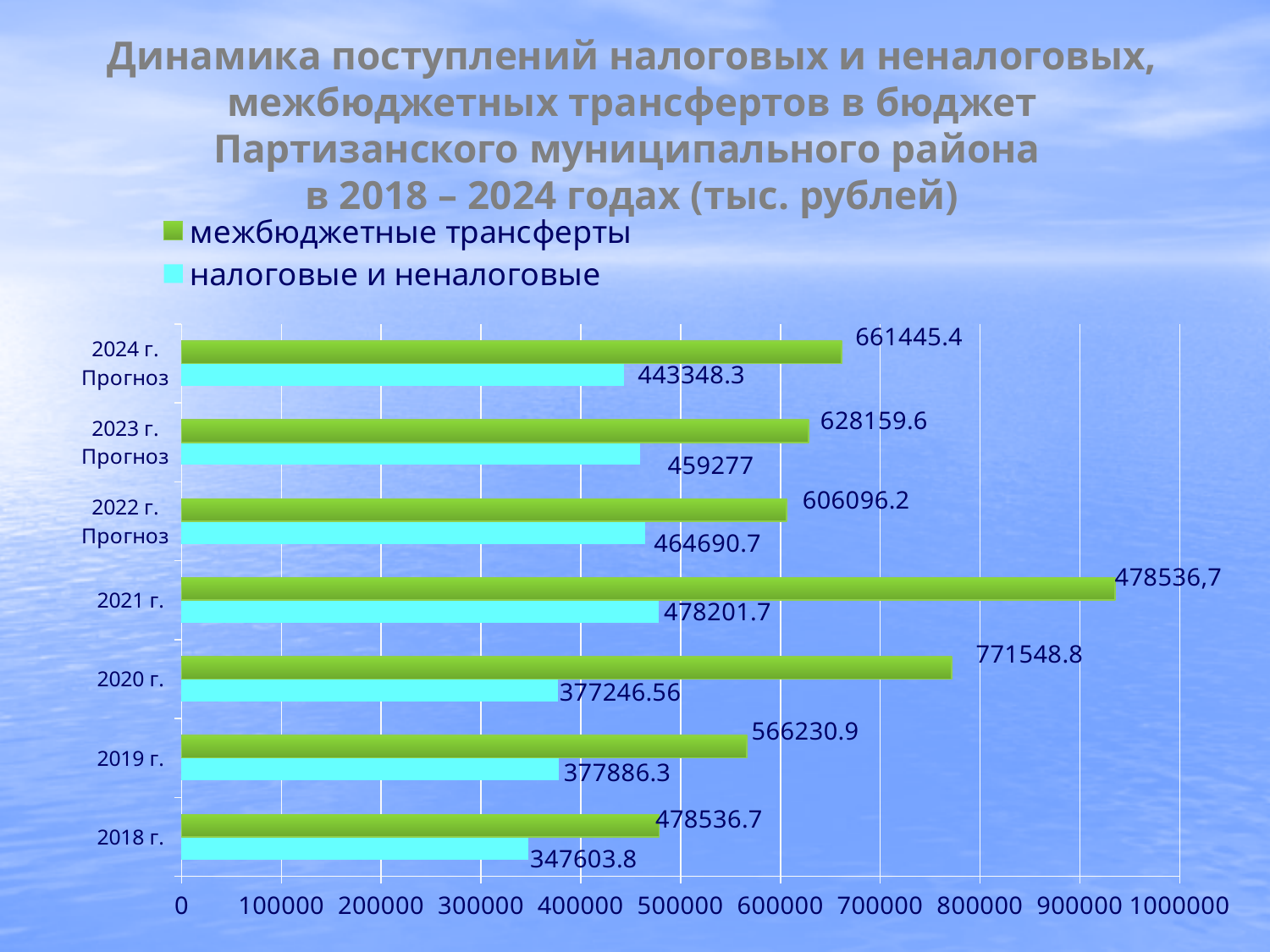
How many series does the legend list? 2 Is the value of межбюджетные трансферты for 2021 г. greater or less than 900000? greater What is the value of межбюджетные трансферты for 2024 г. Прогноз? 661445.4 How many year categories are shown on the chart? 7 What is the value of межбюджетные трансферты for 2023 г. Прогноз? 628159.6 Which year has the lowest value for налоговые и неналоговые? 2018 г. What is the value of налоговые и неналоговые for 2020 г.? 377246.56 What is the difference between межбюджетные трансферты and налоговые и неналоговые for 2024 г. Прогноз? 218097.1 What type of chart is shown on the slide? bar chart Which year has the highest value for налоговые и неналоговые? 2021 г. What is the value of налоговые и неналоговые for 2018 г.? 347603.8 Which is larger: межбюджетные трансферты for 2023 г. Прогноз or for 2024 г. Прогноз? 2024 г. Прогноз